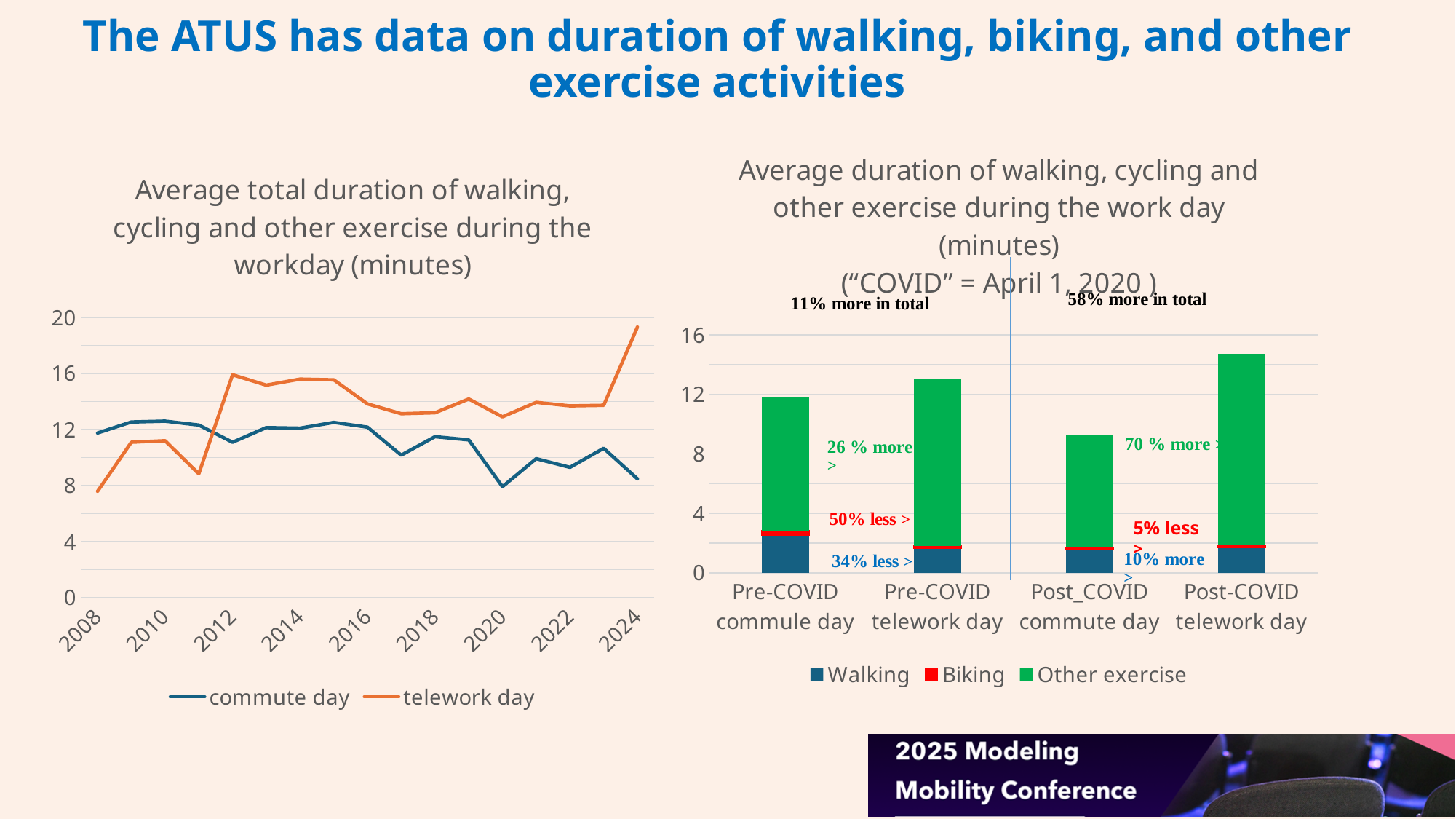
How many series does the legend of the left chart list? 2 What kind of chart is the right chart, 'Average duration of walking, cycling and other exercise during the work day (minutes)'? stacked bar chart How many categories are shown on the x axis of the right chart? 4 What kind of chart is the left chart, 'Average total duration of walking, cycling and other exercise during the workday (minutes)'? line chart In the left chart, is the commute day value for 2020 greater or less than 12? less In the left chart, which series has the higher value in 2008, commute day or telework day? commute day In the right chart, which category has the shortest stacked bar? Post_COVID commute day In the left chart, is the telework day value for 2024 greater or less than 16? greater In the right chart, which category has the tallest stacked bar? Post-COVID telework day How many series does the legend of the right chart list? 3 In the left chart, which series has the higher value in 2024, commute day or telework day? telework day In the right chart, is the total for Post-COVID telework day greater or less than 12? greater